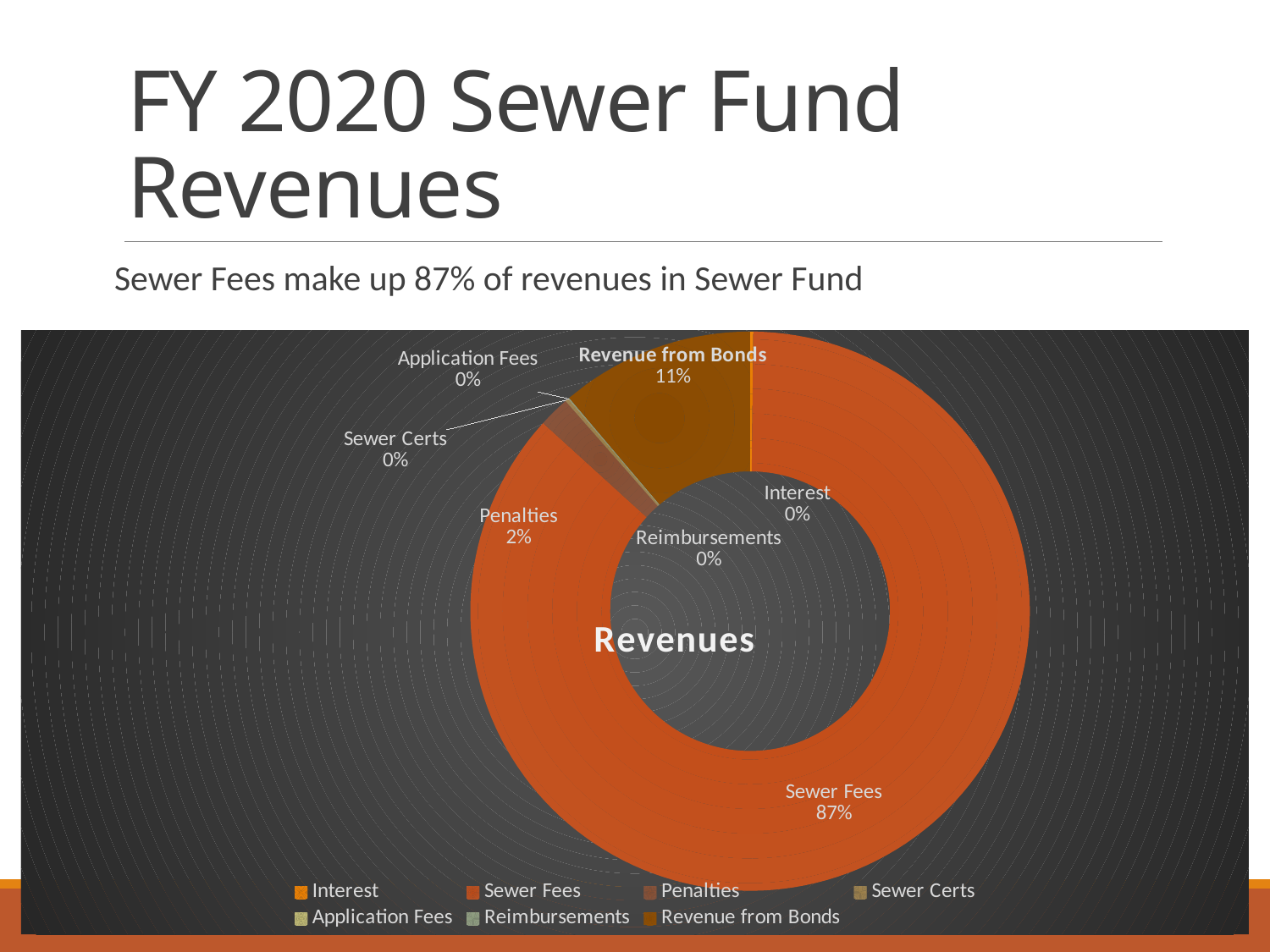
What title is printed in the centre of the chart? Revenues How many percentage points larger is the Sewer Fees share than the Revenue from Bonds share? 76 How many entries does the legend of the Revenues chart list? 7 What share of the Revenues chart is Revenue from Bonds? 11% How many categories are labelled in the Revenues chart? 7 What kind of chart is shown on the slide? Doughnut (pie) chart What percentage is shown for Penalties in the Revenues chart? 2% Which is larger in the Revenues chart, Revenue from Bonds or Penalties? Revenue from Bonds What percentage is shown for Interest in the Revenues chart? 0% What percentage of revenues do Sewer Fees make up in the Revenues chart? 87% What percentage is shown for Application Fees in the Revenues chart? 0% Which category has the largest share of the Revenues chart? Sewer Fees